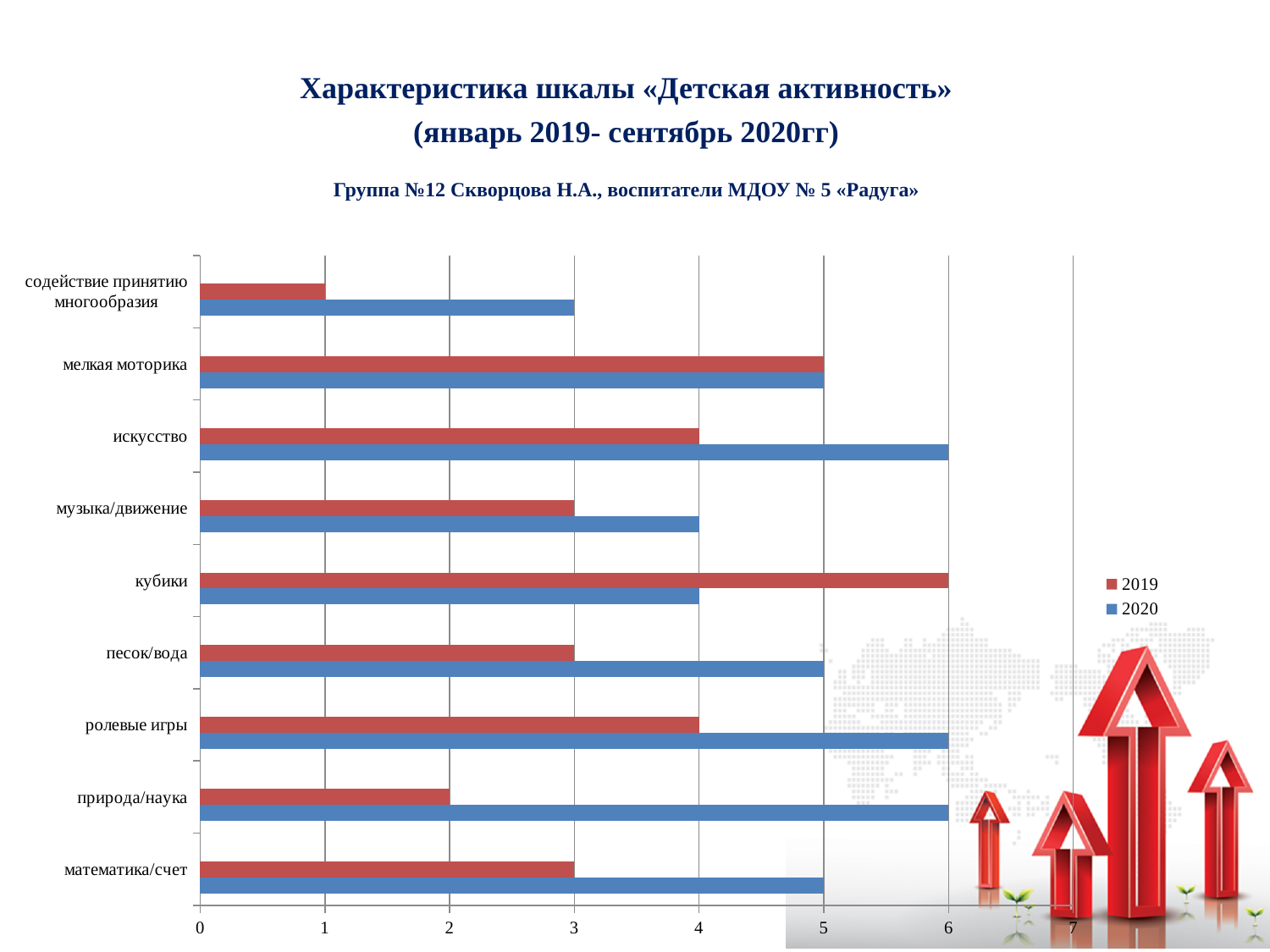
What is the 2020 value for природа/наука? 6 What is the difference between the 2020 and 2019 values for природа/наука? 4 What is the 2019 value for кубики? 6 Which category has the lowest 2020 value? содействие принятию многообразия Is the 2020 value for ролевые игры greater or less than 5? greater What kind of chart is shown on the slide? bar chart How many categories are shown on the chart? 9 Which series is shown in red in the legend? 2019 What is the 2019 value for содействие принятию многообразия? 1 For кубики, which is larger: the 2019 value or the 2020 value? 2019 How many series does the legend list? 2 Which category has the highest 2019 value? кубики